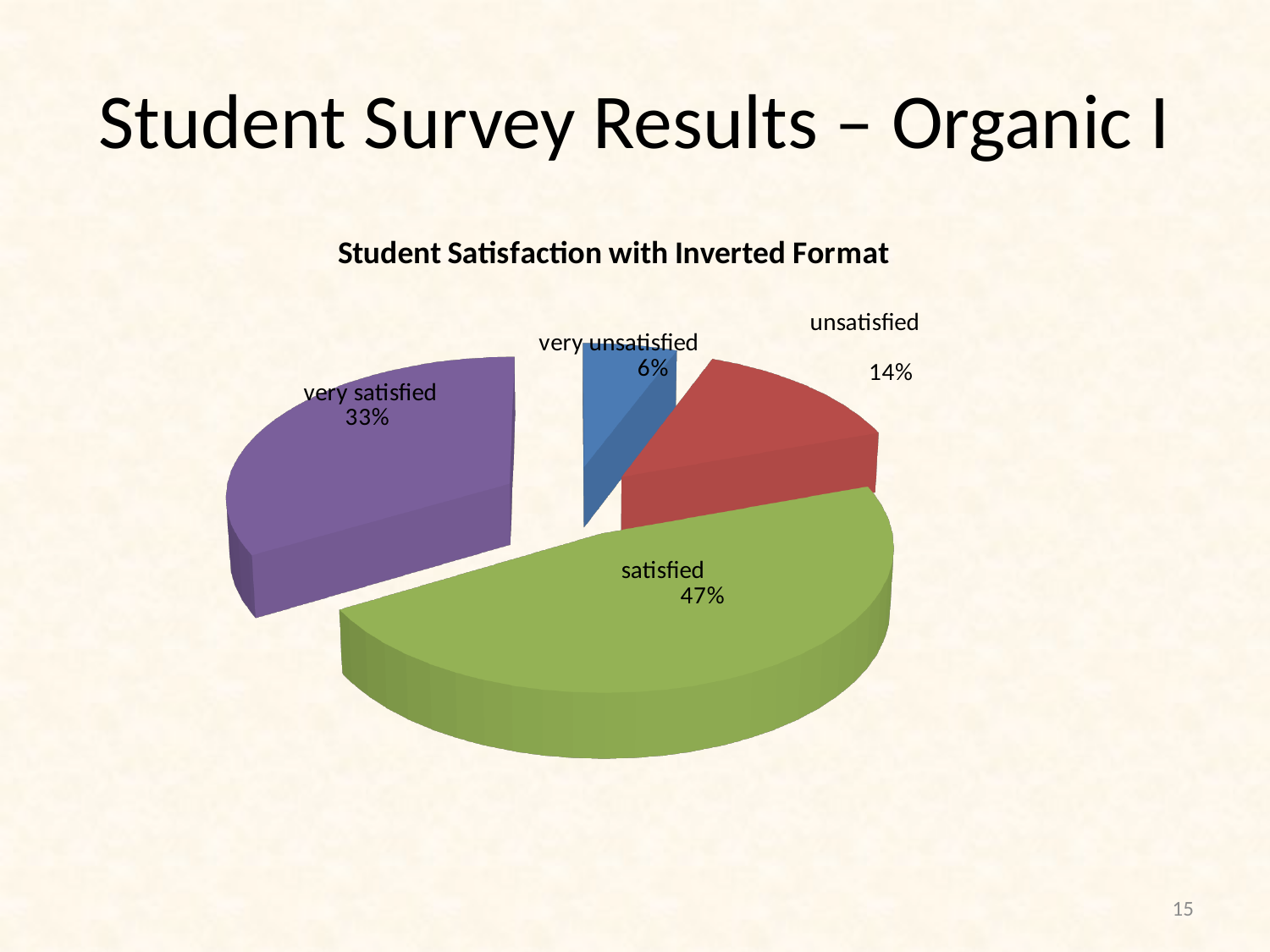
Which is larger, the share for unsatisfied or the share for very unsatisfied? unsatisfied What colour is the slice for very satisfied? purple What percentage of students were unsatisfied? 14% What percentage of students were very satisfied? 33% Which category has the largest share of the pie? satisfied What percentage of students were satisfied? 47% Which category has the smallest share of the pie? very unsatisfied How many categories are shown in the pie chart? 4 What kind of chart is shown on the slide? pie chart What is the difference in percentage points between satisfied and very satisfied? 14 What percentage of students were very unsatisfied? 6% What is the title of the chart? Student Satisfaction with Inverted Format